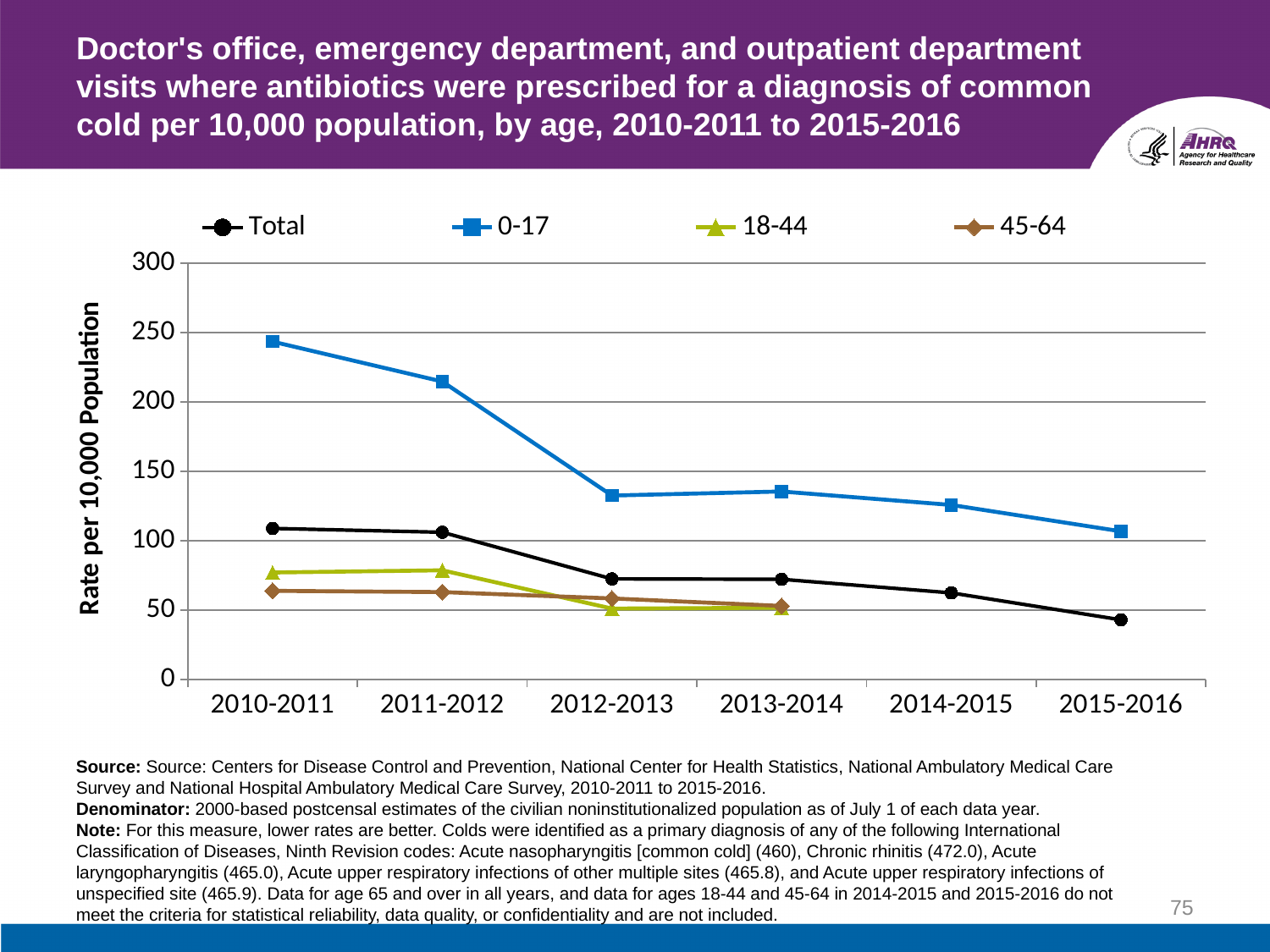
Which age group has the highest rate in 2010-2011? 0-17 How many time periods are shown on the x axis? 6 Is the value for the 0-17 group in 2010-2011 greater or less than 200? greater What kind of chart is shown on the slide? line chart Is the Total value in 2015-2016 greater or less than 50? less How many series does the legend list? 4 Does the rate for the 0-17 group rise or fall from 2010-2011 to 2015-2016? fall Which is larger in 2012-2013, the value for 0-17 or the value for Total? 0-17 In which period is the rate for the 0-17 group highest? 2010-2011 What is the label on the y axis? Rate per 10,000 Population In which period is the Total rate lowest? 2015-2016 Is the value for the 0-17 group in 2015-2016 greater or less than 150? less